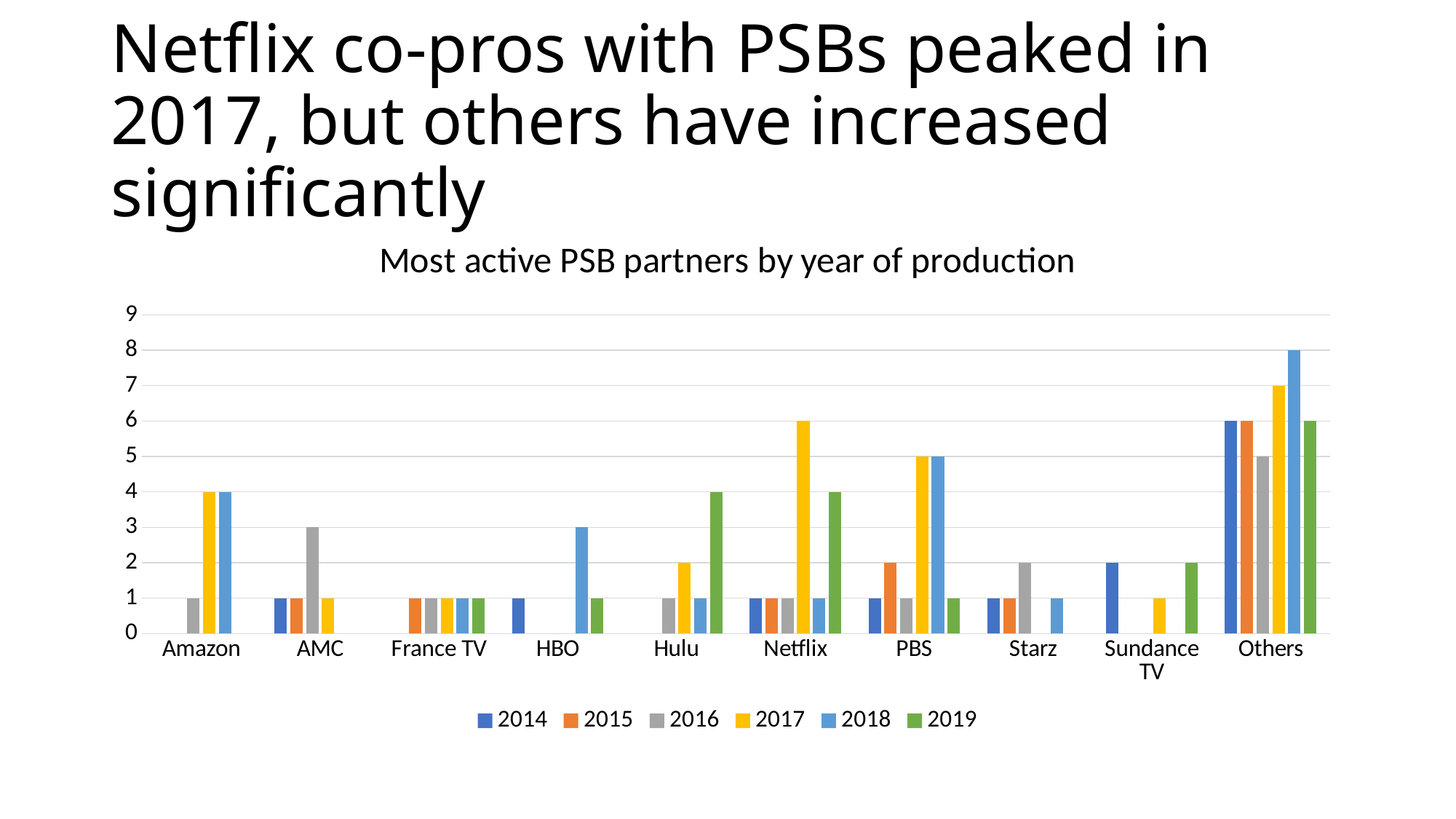
What is the difference between the Netflix values for 2017 and 2019? 2 In which year did Netflix have its highest value? 2017 What is the value for Netflix in 2017? 6 What is the value for Others in 2018? 8 Is the value for Others in 2017 greater or less than 5? greater What kind of chart is shown on the slide? bar chart How many series does the legend list? 6 What is the value for AMC in 2016? 3 What is the title of the chart? Most active PSB partners by year of production Which category has the highest value for 2018? Others How many partner categories are shown on the x axis? 10 Which is larger for Hulu: the 2019 value or the 2017 value? 2019